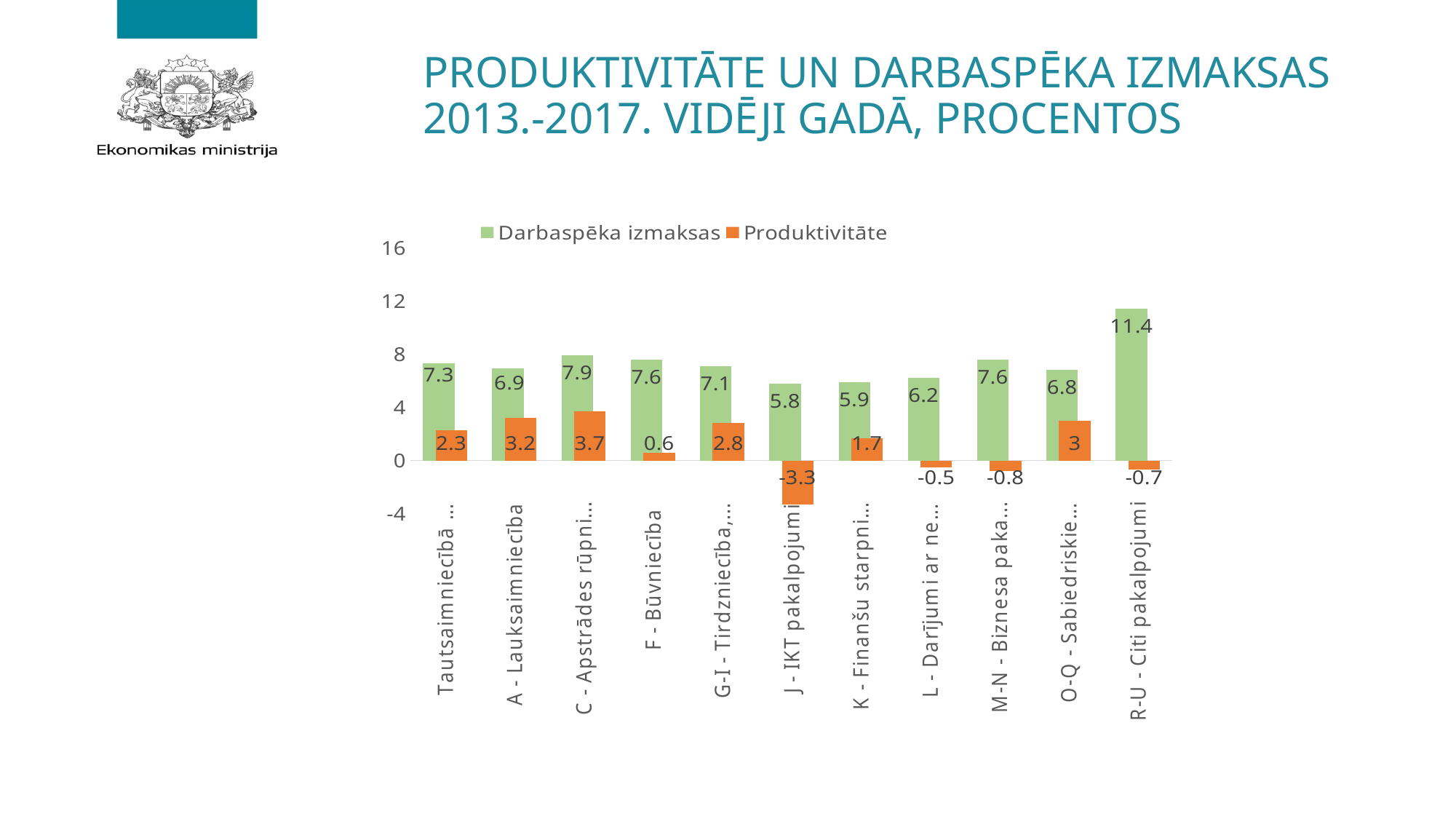
What is the Produktivitāte value for A - Lauksaimniecība? 3.2 Which category has the lowest Produktivitāte value? J - IKT pakalpojumi Is the Darbaspēka izmaksas value for R-U - Citi pakalpojumi greater or less than 8? greater What is the difference between the Darbaspēka izmaksas and Produktivitāte values for F - Būvniecība? 7 Which category has the highest Darbaspēka izmaksas value? R-U - Citi pakalpojumi Which is larger for A - Lauksaimniecība: Darbaspēka izmaksas or Produktivitāte? Darbaspēka izmaksas What is the Produktivitāte value for J - IKT pakalpojumi? -3.3 What kind of chart is shown on the slide? Bar chart How many series does the legend list? 2 What is the Darbaspēka izmaksas value for F - Būvniecība? 7.6 What is the Darbaspēka izmaksas value for R-U - Citi pakalpojumi? 11.4 How many categories are shown on the x axis of the chart? 11